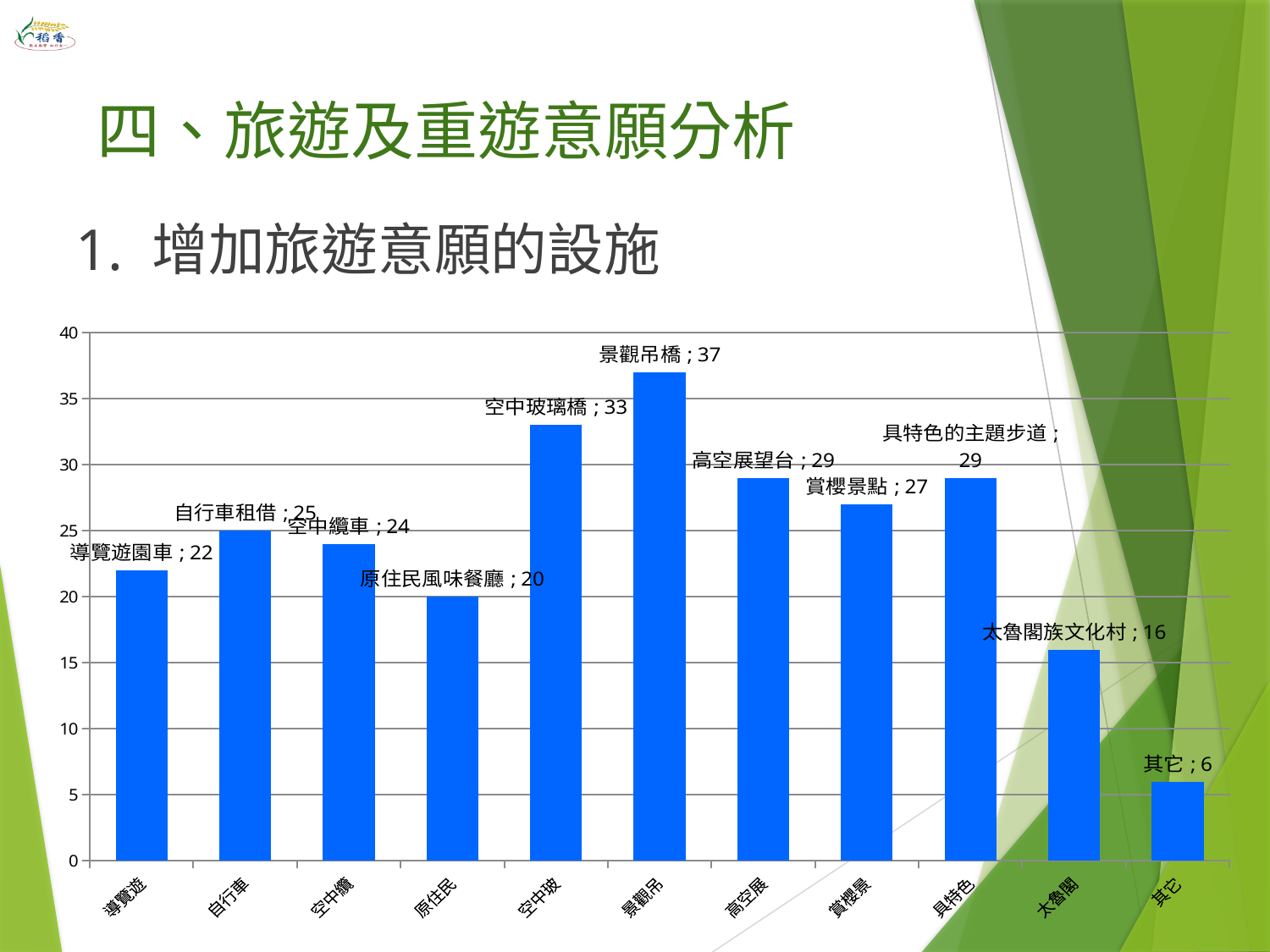
What kind of chart is shown on the slide? bar chart What is the title of the section above the chart? 1. 增加旅遊意願的設施 What is the value for 空中玻璃橋? 33 Which category has the lowest value? 其它 What is the value for 原住民風味餐廳? 20 What is the difference between the values for 自行車租借 and 其它? 19 What is the value for 太魯閣族文化村? 16 Which category has the highest value? 景觀吊橋 How many categories are shown in the chart? 11 What is the value for 景觀吊橋? 37 What is the difference between the values for 景觀吊橋 and 空中玻璃橋? 4 Which is larger, the value for 賞櫻景點 or the value for 空中纜車? 賞櫻景點